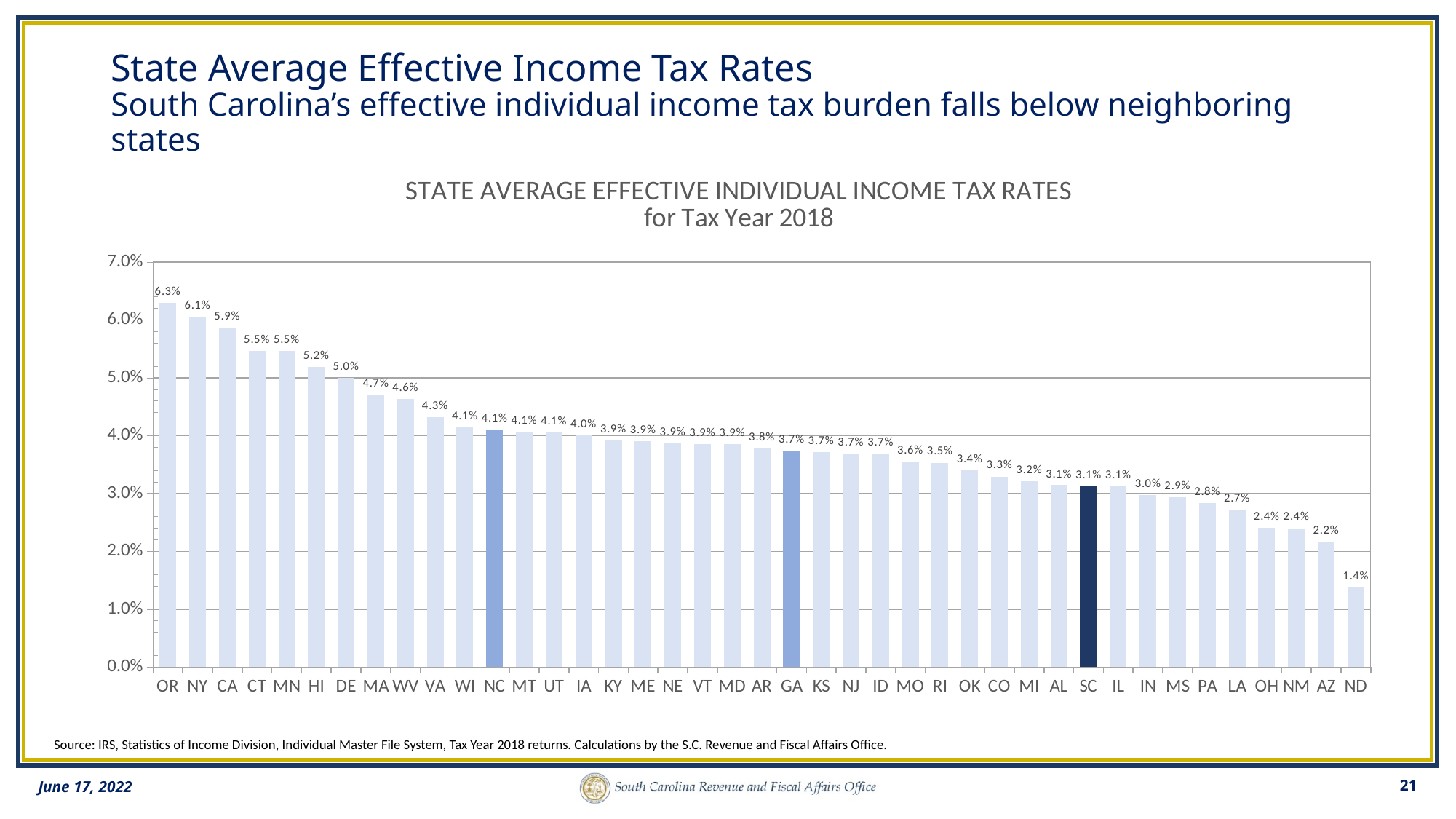
What is the difference between the rates for OR and ND? 4.9 percentage points Do the values rise or fall moving from left to right along the x axis? Fall What kind of chart is shown on the slide? Bar chart What is the difference between the rates for NC and SC? 1.0 percentage points What is the value shown for NC? 4.1% Which state has the lowest average effective individual income tax rate on the chart? ND What is the value shown for GA? 3.7% How many states are shown on the chart? 41 Which has a higher rate, GA or SC? GA Which state's bar is shaded in the darkest navy colour? SC Which state has the highest average effective individual income tax rate on the chart? OR What is the average effective individual income tax rate shown for SC? 3.1%